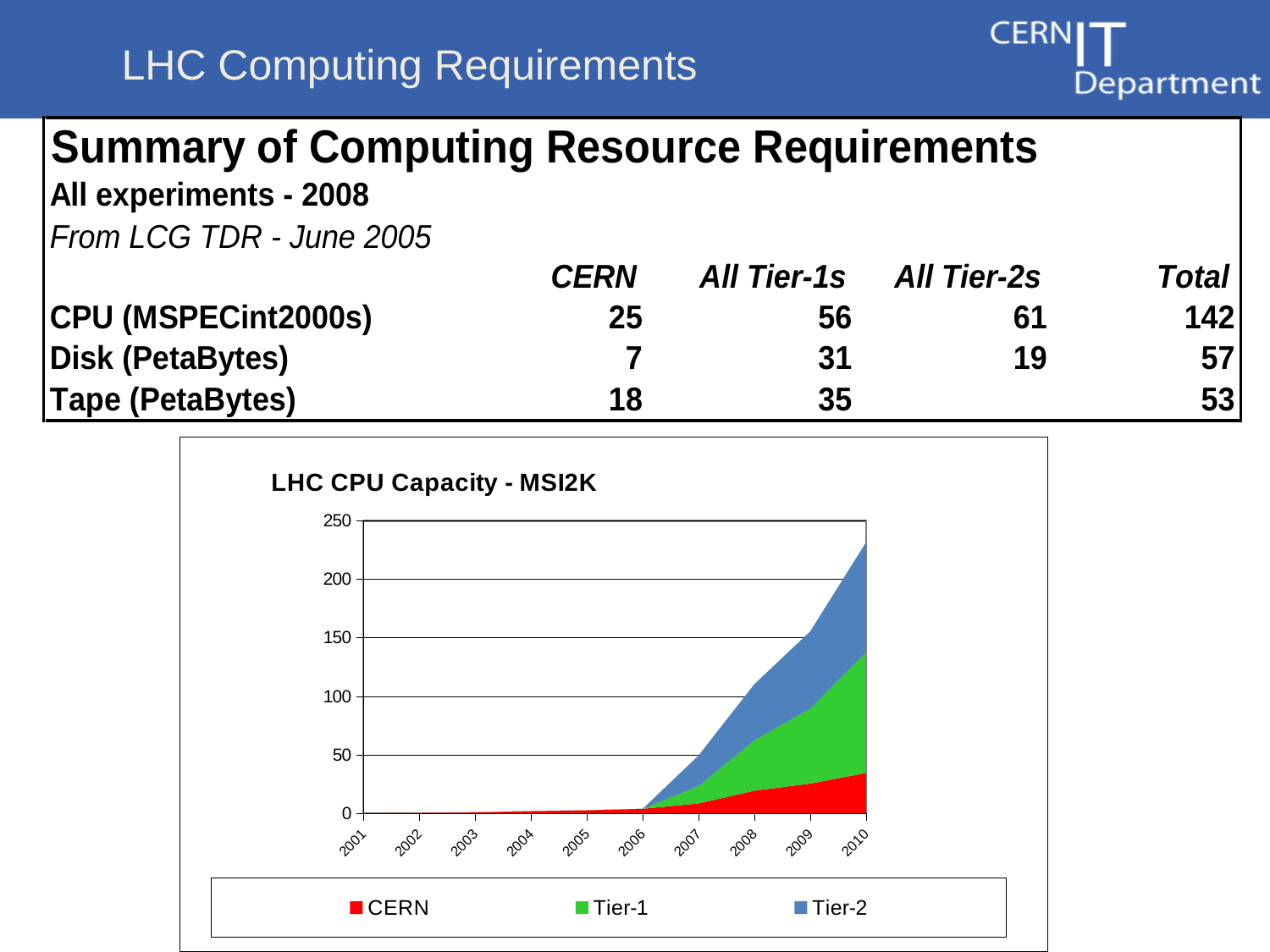
Is the total stacked CPU capacity in 2006 greater or less than 50? less Which is larger in 2010: the total stacked capacity or the CERN capacity alone? the total stacked capacity Is the total stacked CPU capacity in 2010 greater or less than 200? greater Does the total LHC CPU capacity rise or fall from 2001 to 2010? rise How many years are shown along the x axis of the chart? 10 Which year has the highest total CPU capacity in the chart? 2010 Is the total stacked CPU capacity in 2005 greater or less than 100? less Which series is shown in red in the chart? CERN What kind of chart is shown on the slide? stacked area chart What is the title of the chart on the slide? LHC CPU Capacity - MSI2K How many series does the chart's legend list? 3